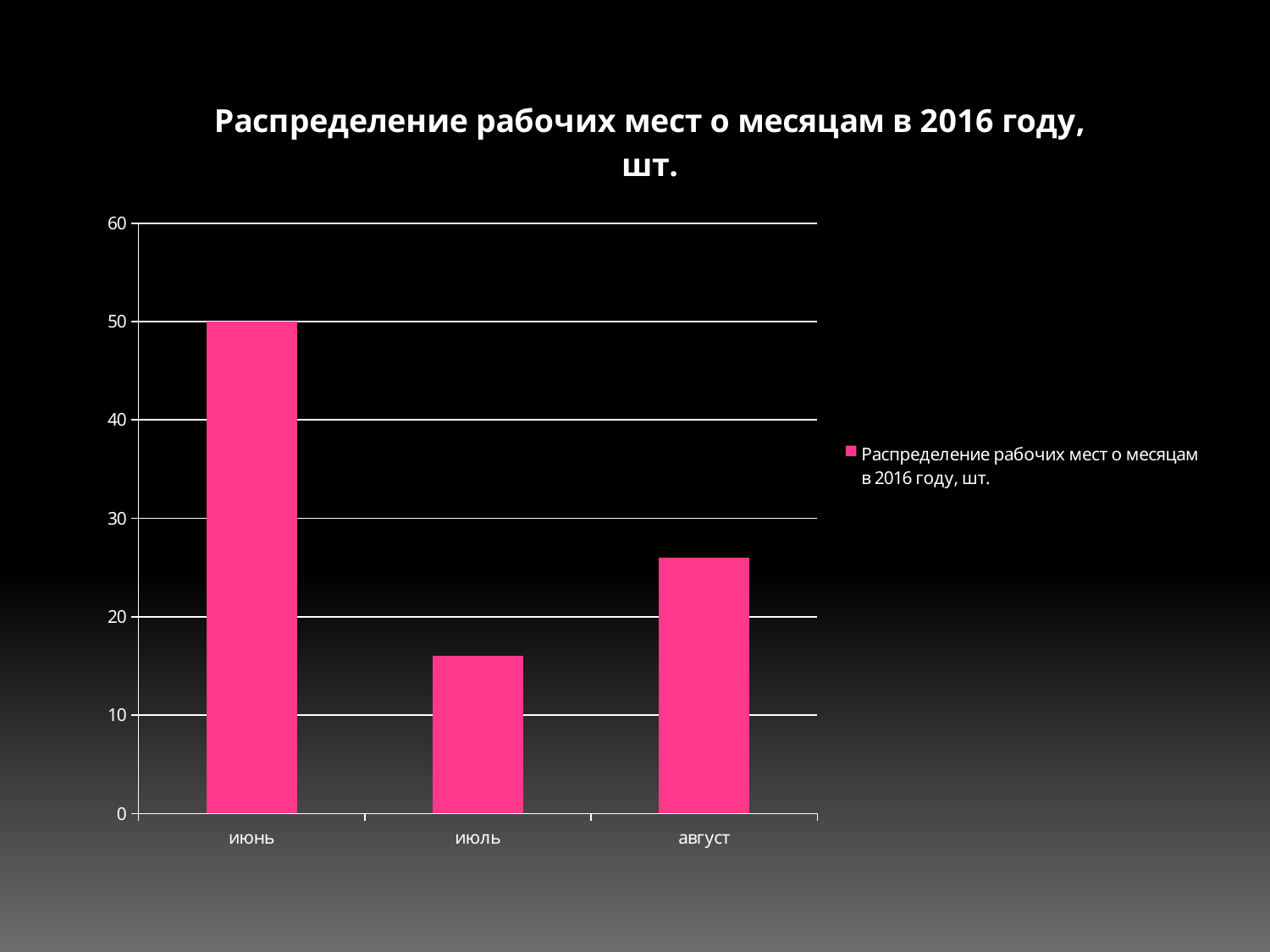
Is the value for июль greater or less than 20? less What is the value for июнь? 50 What colour are the bars in the chart? pink What is the title of the chart? Распределение рабочих мест о месяцам в 2016 году, шт. Which month has the lowest value? июль How many series does the legend list? 1 Which month has the highest value? июнь How many months are shown on the x axis of the chart? 3 Is the value for август greater or less than 20? greater What kind of chart is shown on the slide? bar chart Which is larger, the value for август or the value for июль? август Is the value for август greater or less than 30? less